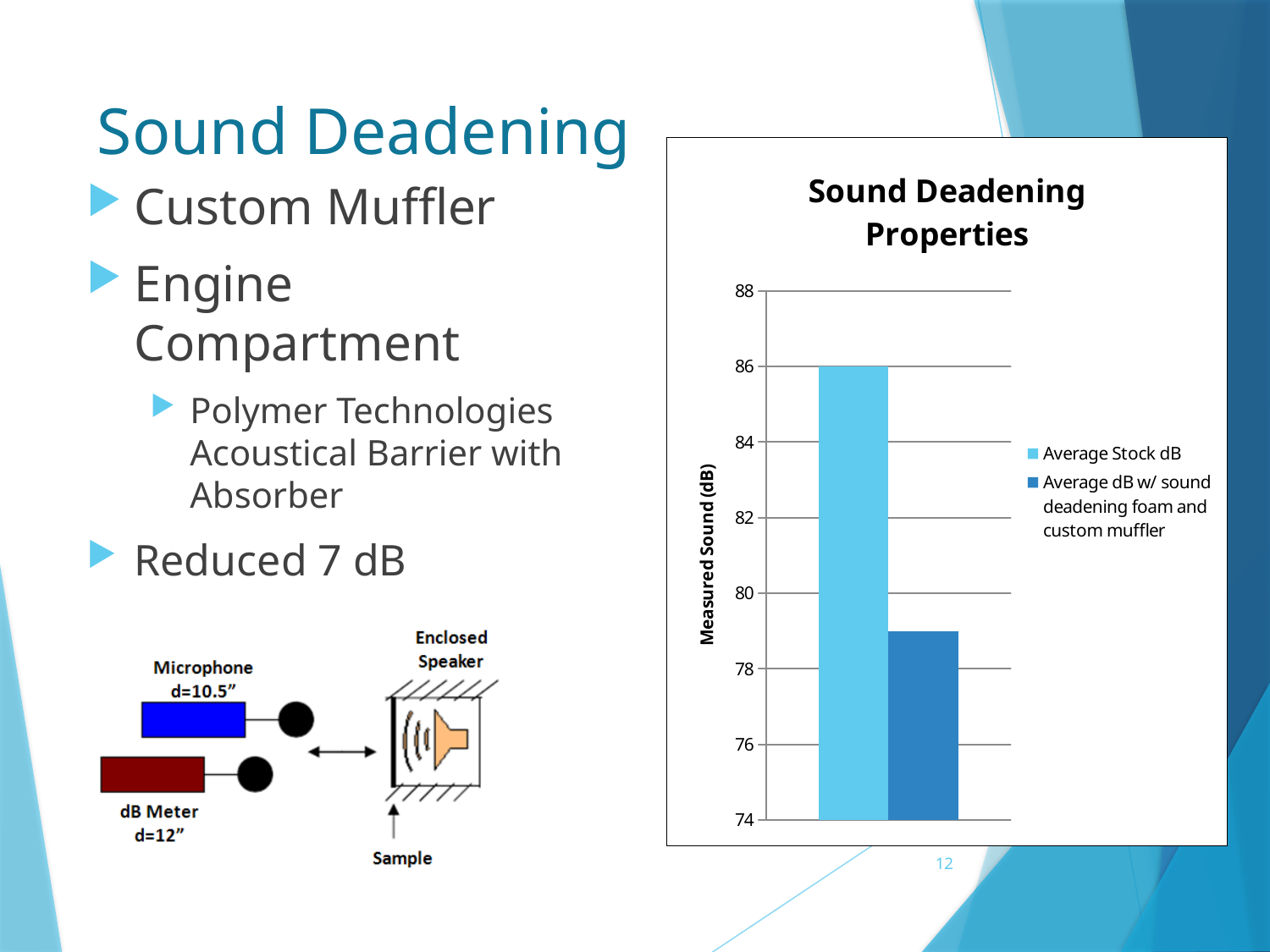
What kind of chart is shown under the title "Sound Deadening Properties"? bar chart In the "Sound Deadening Properties" chart, which series has the lower bar? Average dB w/ sound deadening foam and custom muffler What is the y-axis label of the "Sound Deadening Properties" chart? Measured Sound (dB) In the "Sound Deadening Properties" chart, is the value for Average Stock dB greater or less than 84? greater What is the title of the chart on the slide? Sound Deadening Properties How many series does the legend of the "Sound Deadening Properties" chart list? 2 In the "Sound Deadening Properties" chart, what is the lowest value shown on the y axis? 74 How many bars are plotted in the "Sound Deadening Properties" chart? 2 In the "Sound Deadening Properties" chart, which is larger: the Average Stock dB bar or the Average dB w/ sound deadening foam and custom muffler bar? Average Stock dB In the "Sound Deadening Properties" chart, which series has the higher bar? Average Stock dB In the "Sound Deadening Properties" chart, is the value for Average dB w/ sound deadening foam and custom muffler greater or less than 80? less In the "Sound Deadening Properties" chart, is the value for Average dB w/ sound deadening foam and custom muffler greater or less than 78? greater